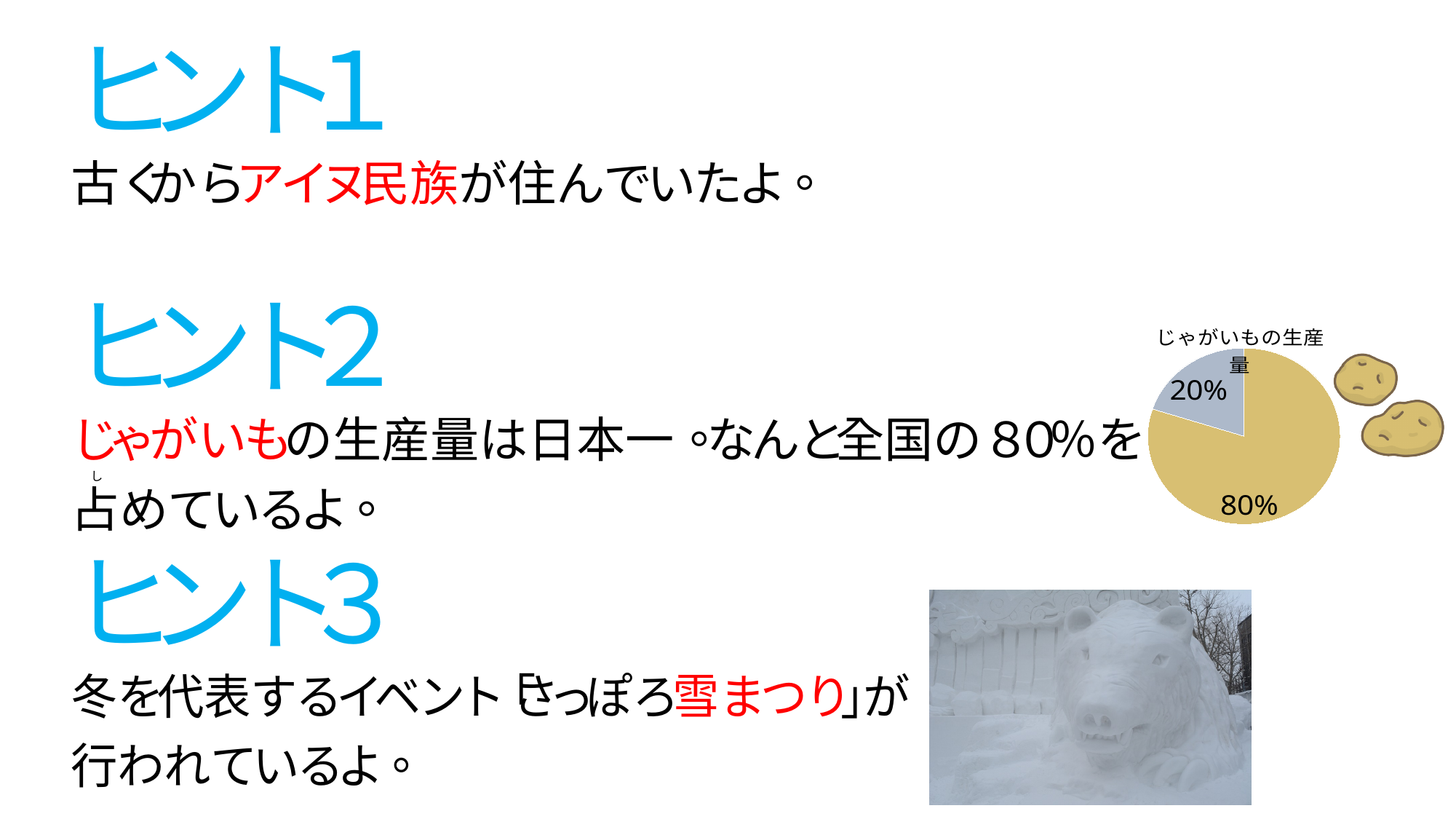
How many slices does the pie chart have? 2 What colour is the slice labelled 80% in the pie chart? yellow What kind of chart is shown on the slide? pie chart What is the title of the pie chart? じゃがいもの生産量 Which slice of the pie chart is larger, the yellow one or the light blue one? the yellow one What is the difference between the two slices of the pie chart? 60% Is the value of the light blue slice greater or less than 50%? less What share of the pie does the light blue slice represent? 20% What percentage is shown on the smallest slice of the pie chart? 20% What share of the pie does the yellow slice represent? 80% What percentage is shown on the largest slice of the pie chart? 80%